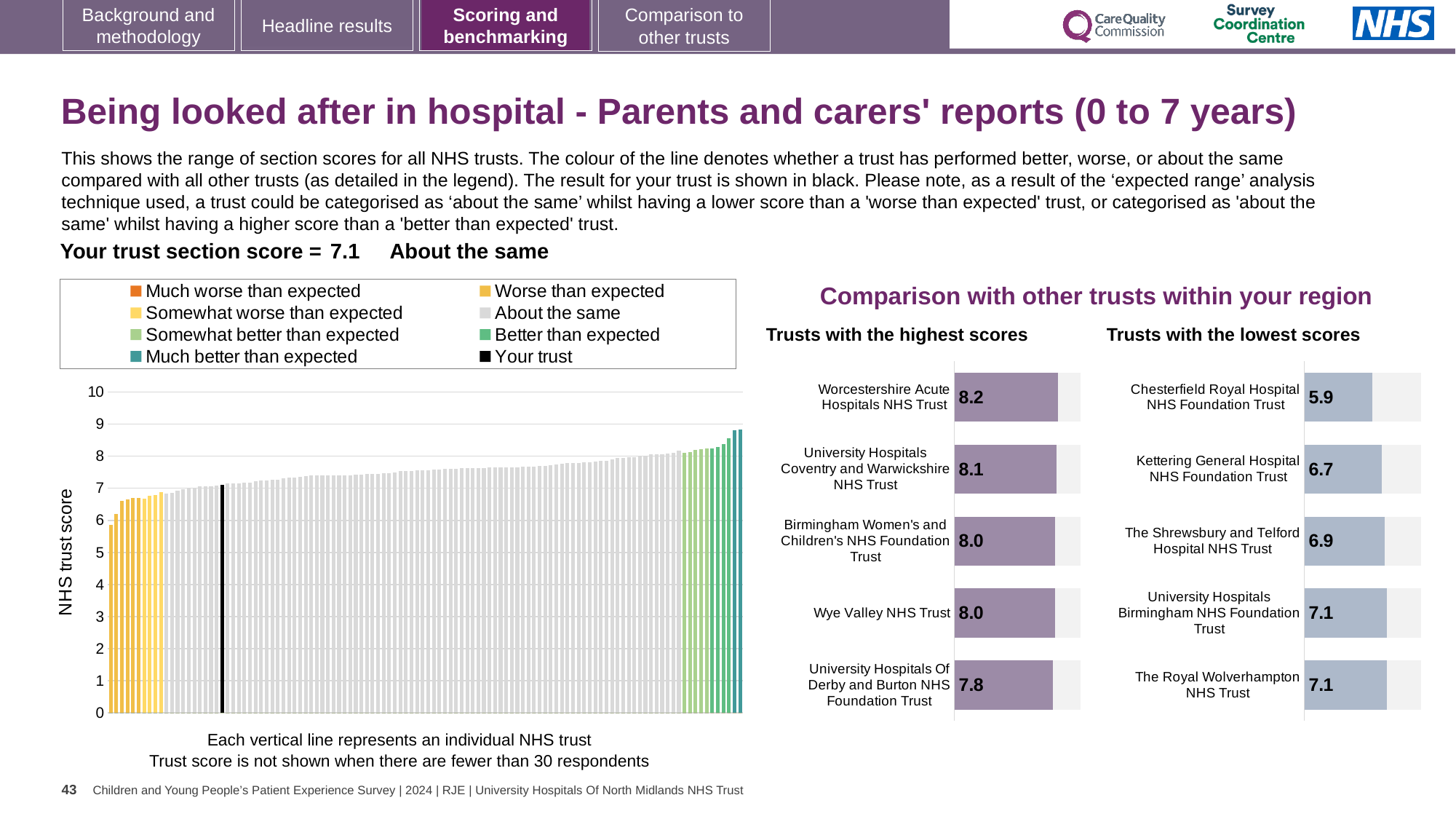
In the NHS trust score chart on the left, do the bar values rise or fall from left to right? Rise In the 'Trusts with the highest scores' chart, what is the difference between the scores of Worcestershire Acute Hospitals NHS Trust and University Hospitals Of Derby and Burton NHS Foundation Trust? 0.4 In the 'Trusts with the highest scores' chart, which trust has the highest score? Worcestershire Acute Hospitals NHS Trust In the 'Trusts with the lowest scores' chart, what is the difference between the scores of Kettering General Hospital NHS Foundation Trust and Chesterfield Royal Hospital NHS Foundation Trust? 0.8 What is the section score for your trust shown on the slide? 7.1 How many trusts are shown in the 'Trusts with the highest scores' chart? 5 In the 'Trusts with the lowest scores' chart, which has the larger score: Kettering General Hospital NHS Foundation Trust or The Shrewsbury and Telford Hospital NHS Trust? The Shrewsbury and Telford Hospital NHS Trust In the NHS trust score chart on the left, is the value of the leftmost bar greater or less than 7? less In the 'Trusts with the lowest scores' chart, what is the score for Chesterfield Royal Hospital NHS Foundation Trust? 5.9 What kind of chart is the 'Trusts with the lowest scores' chart? Bar chart In the 'Trusts with the lowest scores' chart, which trust has the lowest score? Chesterfield Royal Hospital NHS Foundation Trust In the 'Trusts with the highest scores' chart, what is the score for Worcestershire Acute Hospitals NHS Trust? 8.2